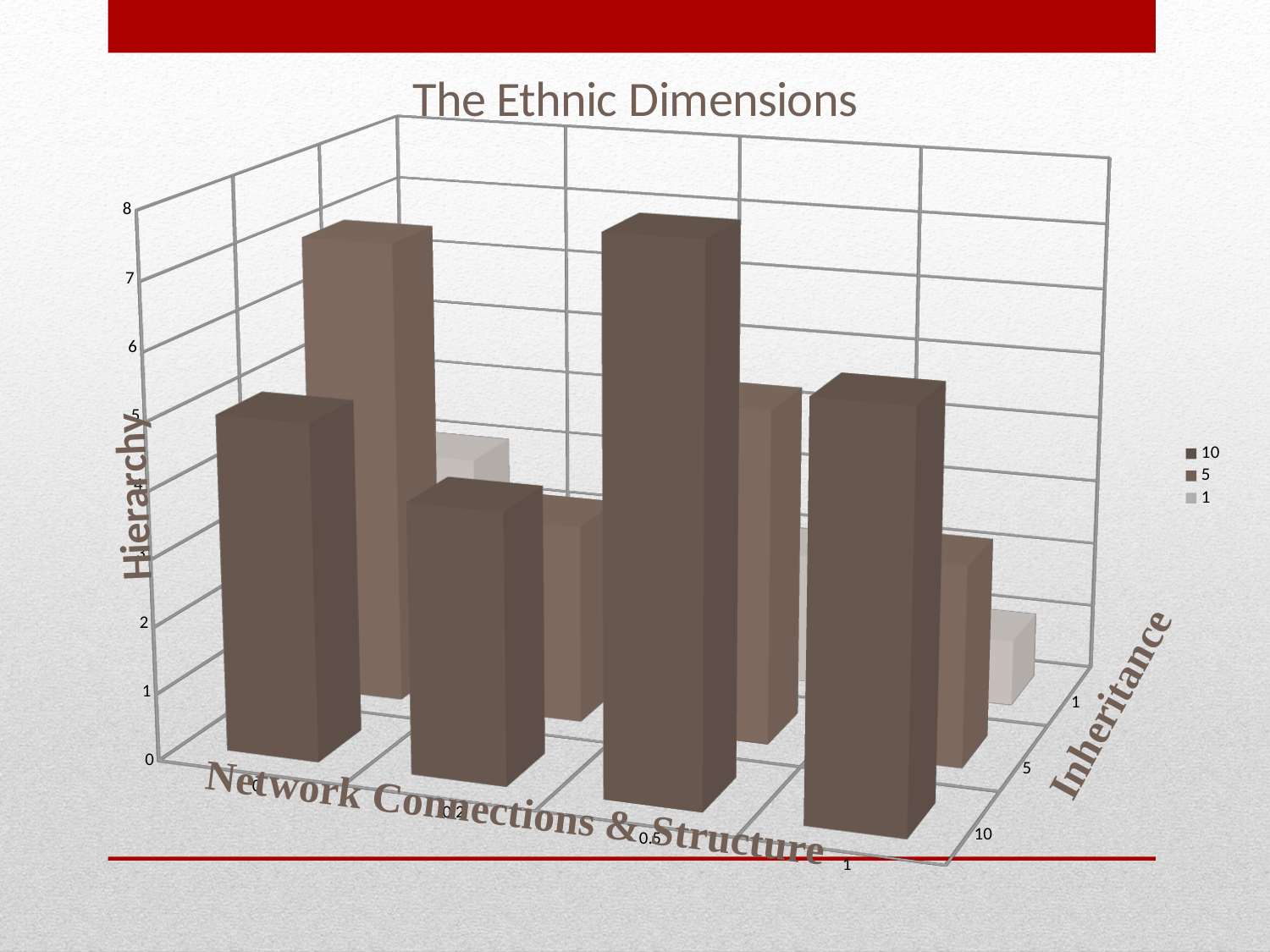
What kind of chart is shown on the slide? bar chart For the series 5, is the bar at 0 taller or shorter than the bar at 1? taller For the series 10, which Network Connections & Structure category has the tallest bar? 0.5 For the series 5, which Network Connections & Structure category has the tallest bar? 0 How many categories are plotted along the Network Connections & Structure axis? 4 What are the entries in the chart's legend? 10, 5, 1 How many series does the legend list? 3 What is the title of the chart? The Ethnic Dimensions For the series 10, is the bar at 0.5 taller or shorter than the bar at 0.2? taller What is the highest value shown on the Hierarchy axis? 8 For the series 10, which Network Connections & Structure category has the shortest bar? 0.2